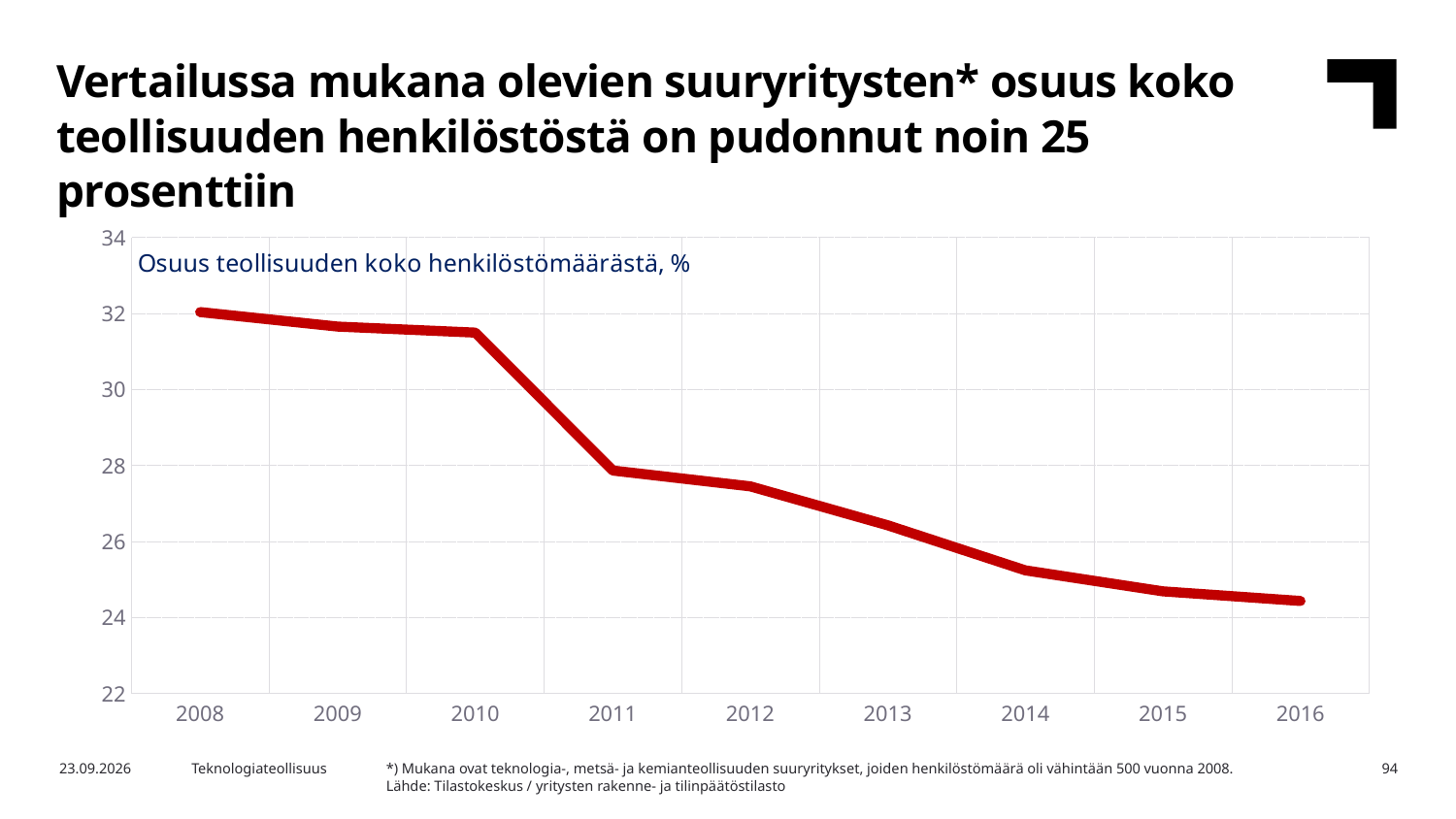
Which year has the highest value? 2008 Which is larger, the value for 2010 or the value for 2011? 2010 Is the value for 2008 greater or less than 30? greater Do the values rise or fall from 2008 to 2016? fall Is the value for 2011 greater or less than 30? less Which year has the lowest value? 2016 What label is printed inside the chart area describing the plotted series? Osuus teollisuuden koko henkilöstömäärästä, % What colour is the plotted line? red What kind of chart is shown on the slide? line chart Is the value for 2016 greater or less than 24? greater How many years are plotted on the x axis? 9